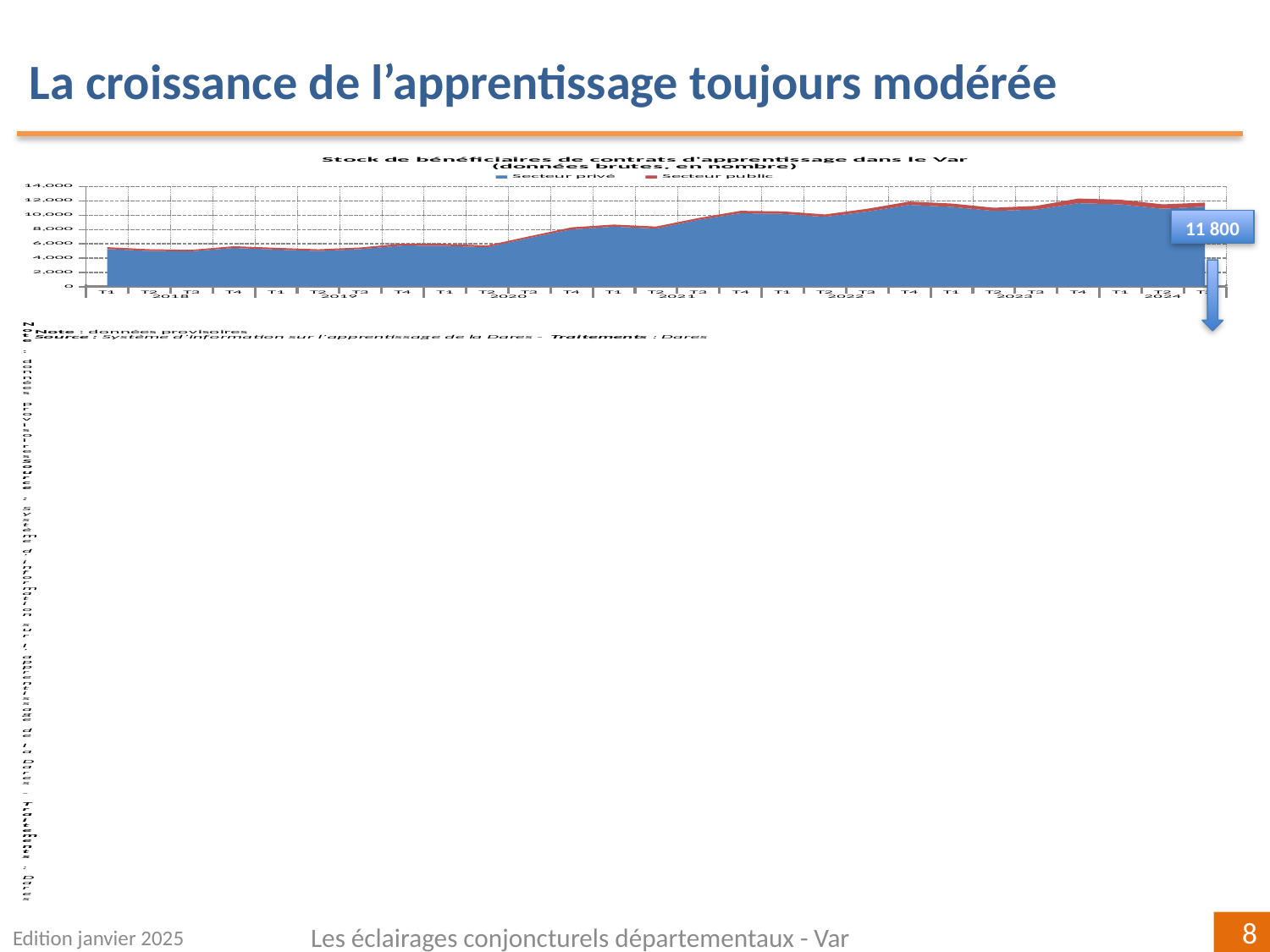
What is the title of the chart? Stock de bénéficiaires de contrats d'apprentissage dans le Var (données brutes, en nombre) What are the two series named in the chart legend? Secteur privé and Secteur public Is the total value for T1 2018 greater or less than 6,000? less Overall, do the values rise or fall from T1 2018 to T3 2024? Rise Is the total value for T4 2023 greater or less than 10,000? greater What value does the callout at the right end of the chart show for the latest quarter? 11 800 How many series does the chart legend list? 2 How many years are labelled along the x axis? 7 Is the total value for T4 2022 greater or less than 10,000? greater Which is larger, the total value for T2 2024 or the total value for T1 2018? T2 2024 What kind of chart is shown on the slide? Area chart